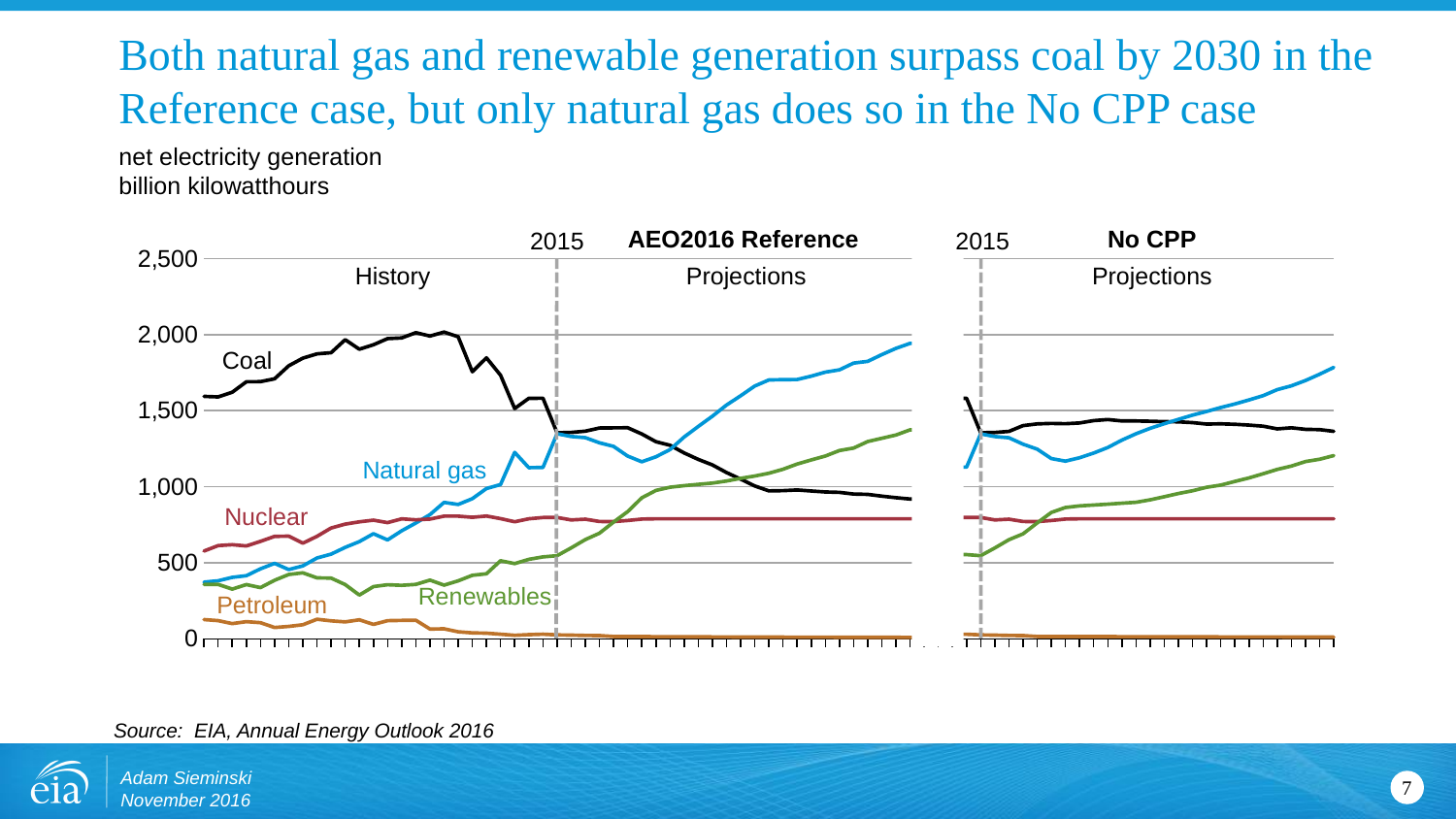
In the AEO2016 Reference chart, which is higher at the end of the projection period, natural gas or coal? Natural gas In the AEO2016 Reference chart, is the renewables value at the end of the projection period greater or less than 1,000? greater In the AEO2016 Reference chart, is the coal value at the end of the projection period greater or less than 1,000? less In the AEO2016 Reference chart, is the natural gas value at the end of the projection period greater or less than 1,500? greater In the No CPP chart, which is higher at the end of the projection period, coal or renewables? Coal In the AEO2016 Reference chart, does natural gas generation rise or fall over the projection period? rise What unit is net electricity generation measured in on the charts? billion kilowatthours What kind of chart is used on this slide? line chart In the AEO2016 Reference chart, does coal generation rise or fall over the projection period? fall How many generation sources are labeled as series on the charts? 5